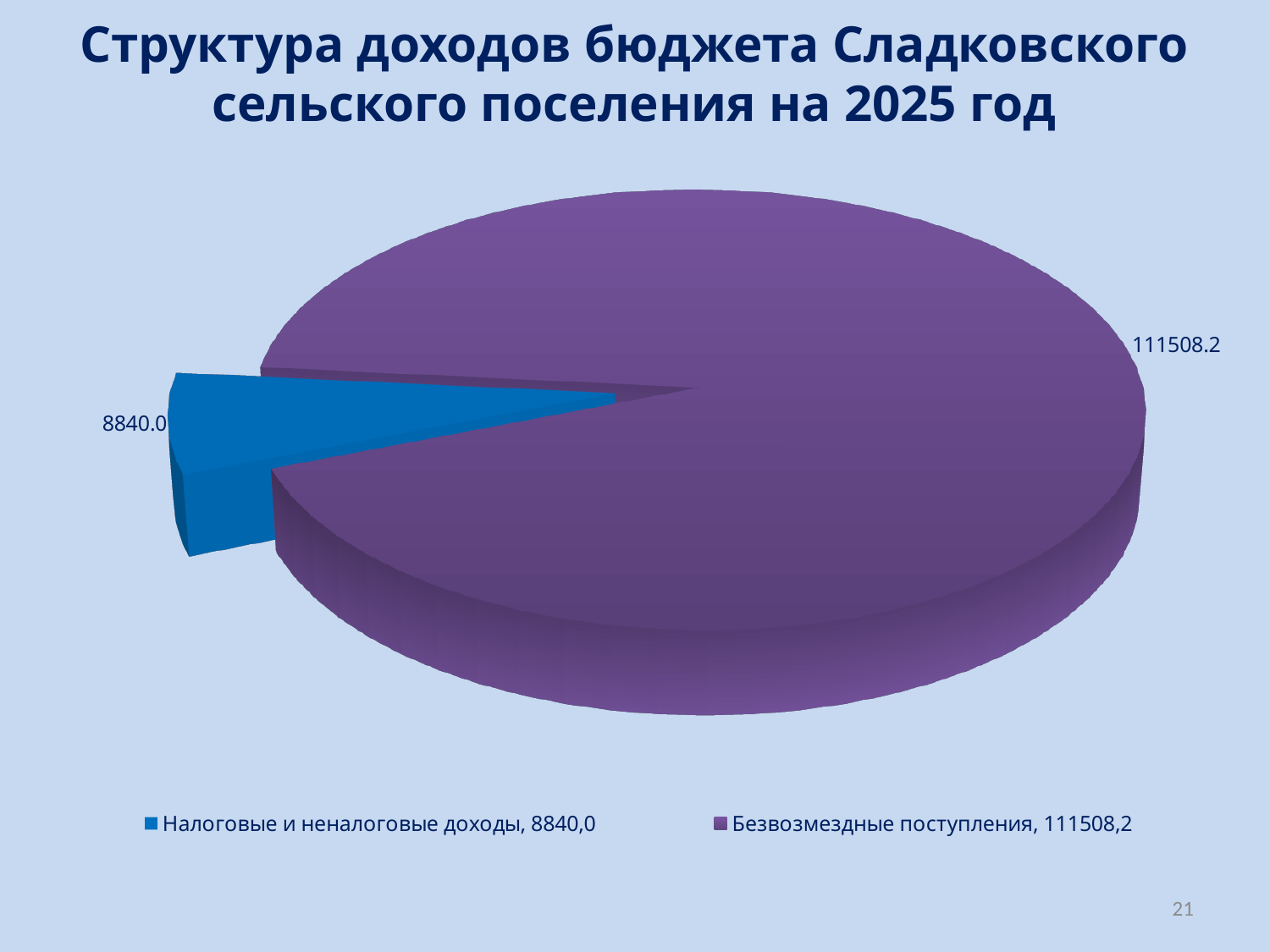
What colour is the slice for Налоговые и неналоговые доходы? Blue What kind of chart is shown on the slide? Pie chart Which category has the smallest slice of the pie? Налоговые и неналоговые доходы What is the value for Безвозмездные поступления? 111508.2 What is the value for Налоговые и неналоговые доходы? 8840.0 What is the total of the two values shown in the pie chart? 120348.2 How many entries does the legend list? 2 What is the title of the chart on the slide? Структура доходов бюджета Сладковского сельского поселения на 2025 год Which category has the largest slice of the pie? Безвозмездные поступления What is the difference between the value for Безвозмездные поступления and the value for Налоговые и неналоговые доходы? 102668.2 Which is larger: Налоговые и неналоговые доходы or Безвозмездные поступления? Безвозмездные поступления How many slices does the pie chart have? 2